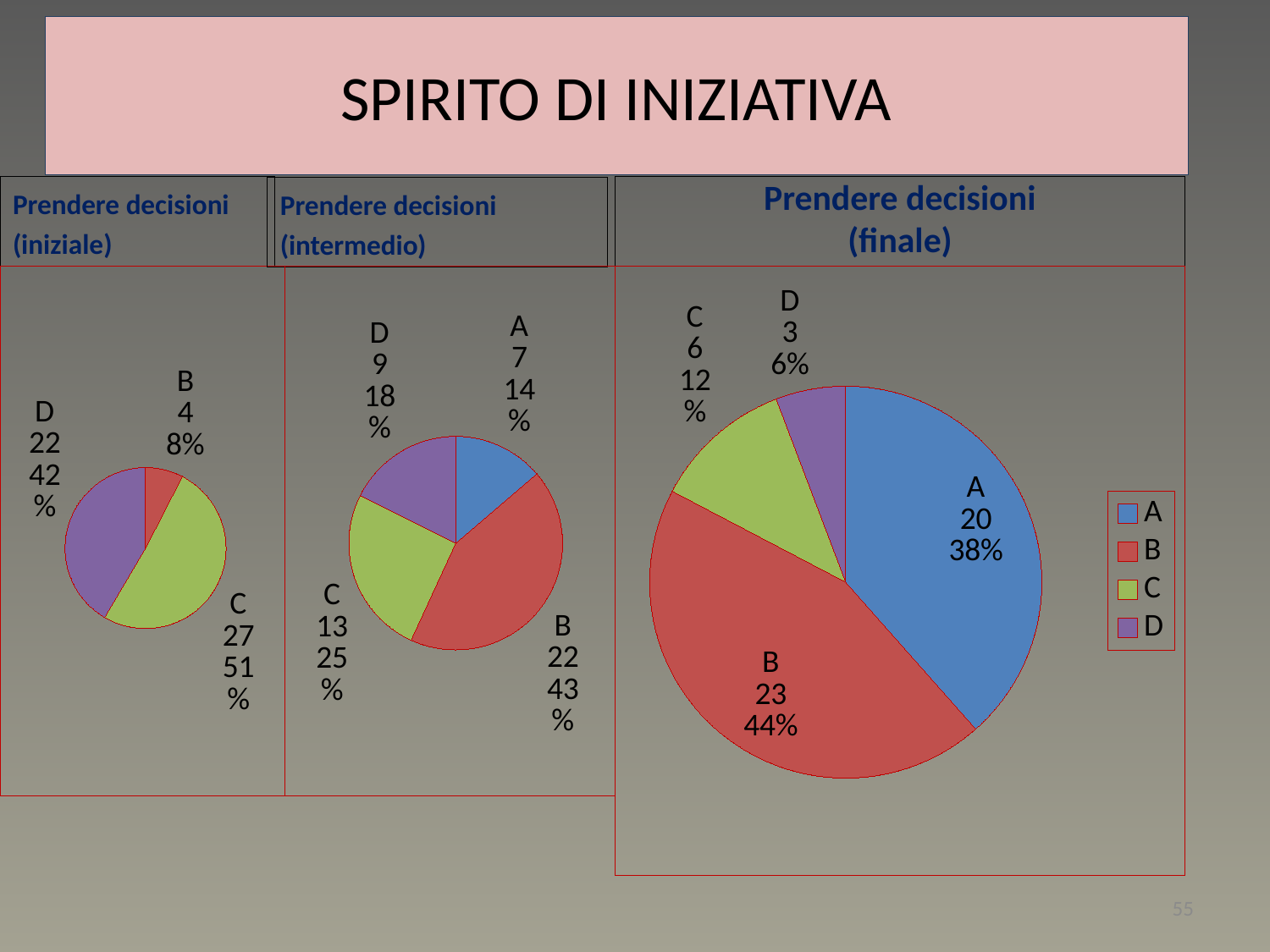
In the 'Prendere decisioni (intermedio)' chart, what is the value for category C? 13 How many entries does the legend of the 'Prendere decisioni (finale)' chart list? 4 In the 'Prendere decisioni (intermedio)' chart, what percentage share does category D have? 18% In the 'Prendere decisioni (intermedio)' chart, which category has the largest slice? B In the 'Prendere decisioni (finale)' chart, what is the value for category B? 23 In the 'Prendere decisioni (finale)' chart, what percentage share does category A have? 38% In the 'Prendere decisioni (finale)' chart, which category has the smallest slice? D In the 'Prendere decisioni (iniziale)' chart, what is the value for category D? 22 In the 'Prendere decisioni (iniziale)' chart, which category has the largest slice? C In the 'Prendere decisioni (iniziale)' chart, which is larger, the value for B or the value for D? D In the 'Prendere decisioni (finale)' chart, what is the difference between the values for B and A? 3 What kind of chart is used for 'Prendere decisioni (finale)'? Pie chart